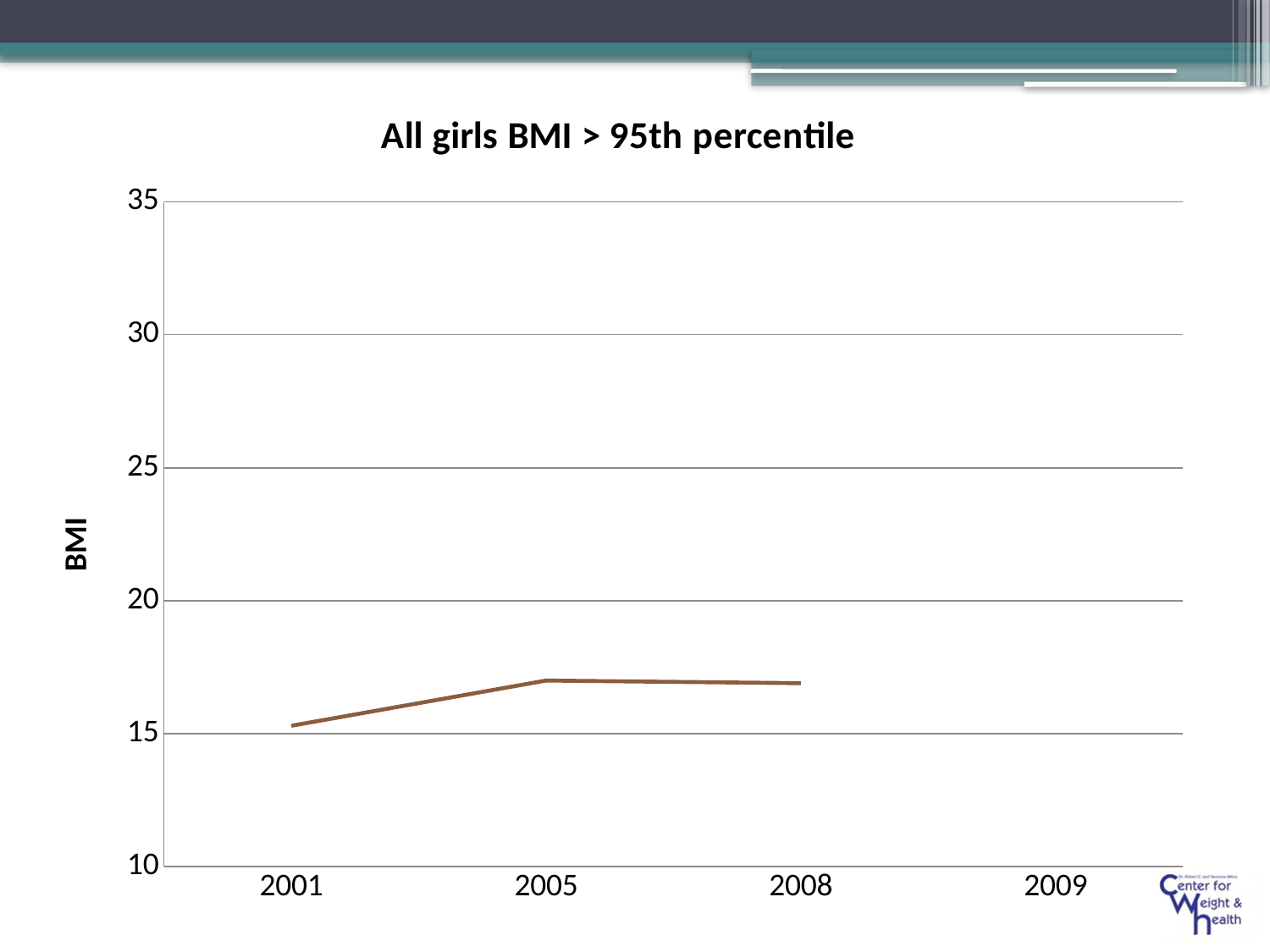
Which year has the lowest plotted BMI value? 2001 Is the value for 2001 greater or less than 20? less Is the value for 2005 greater or less than 15? greater Which is larger, the value for 2001 or the value for 2005? 2005 Is the value for 2008 greater or less than 20? less Which year on the x axis has no plotted value on the line? 2009 How many year labels are shown on the x axis? 4 What is the label on the vertical axis of the chart? BMI Does the line rise or fall from 2001 to 2005? rise What kind of chart is shown on the slide? line chart What is the title of the chart? All girls BMI > 95th percentile